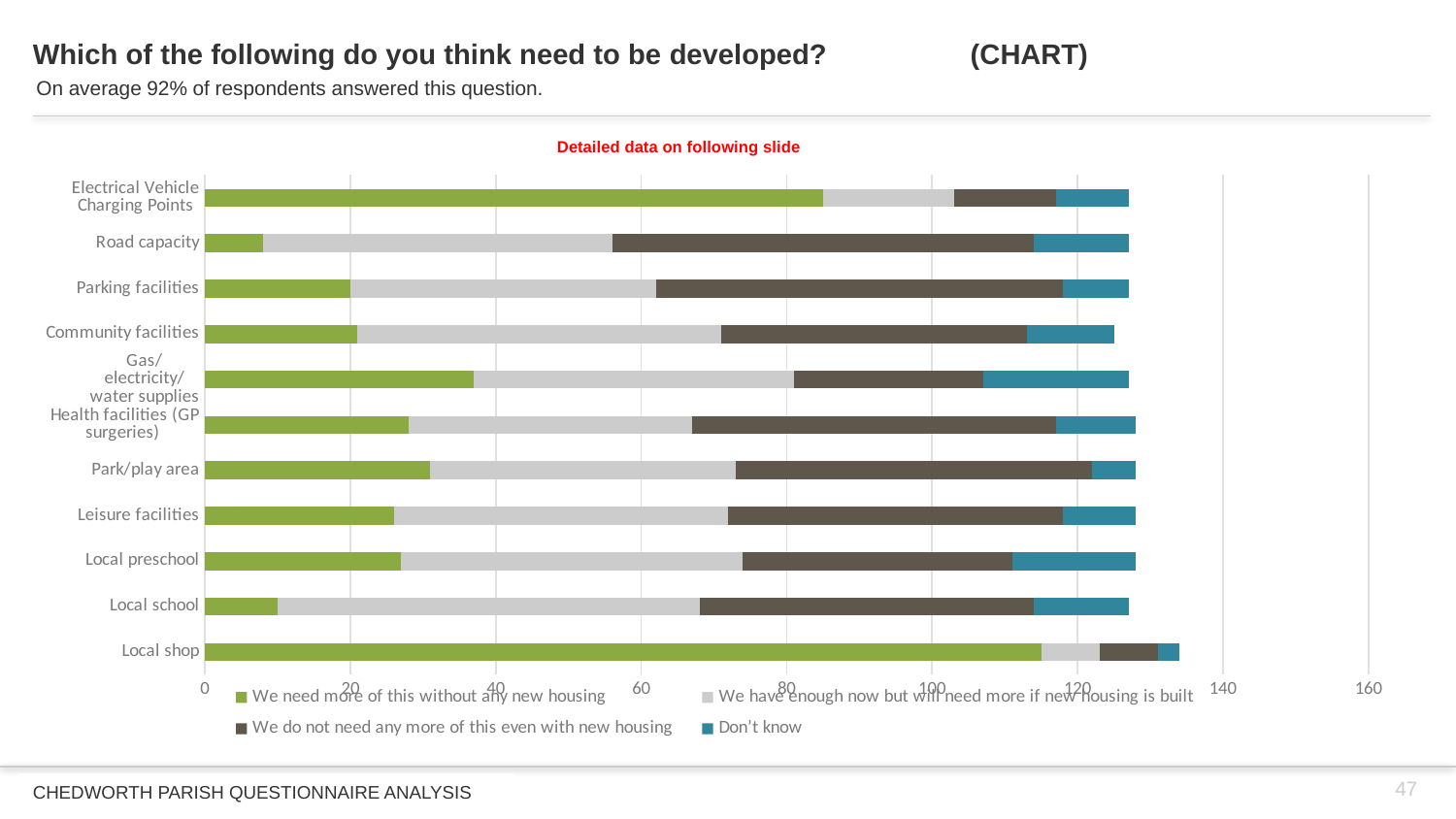
How many categories are listed on the vertical axis of the chart? 11 How many series does the chart legend list? 4 Is the 'We need more of this without any new housing' value for Local shop greater or less than 100? greater Which legend entry is shown in green? We need more of this without any new housing Is the 'We need more of this without any new housing' value for Gas/electricity/water supplies greater or less than 20? greater Is the 'We need more of this without any new housing' value for Road capacity greater or less than 20? less What is the title of the chart on the slide? Which of the following do you think need to be developed? Which category has the largest 'We need more of this without any new housing' segment? Local shop Which has the larger 'We need more of this without any new housing' segment: Electrical Vehicle Charging Points or Road capacity? Electrical Vehicle Charging Points What kind of chart is shown on the slide? Stacked bar chart Which has the larger 'We do not need any more of this even with new housing' segment: Road capacity or Local shop? Road capacity